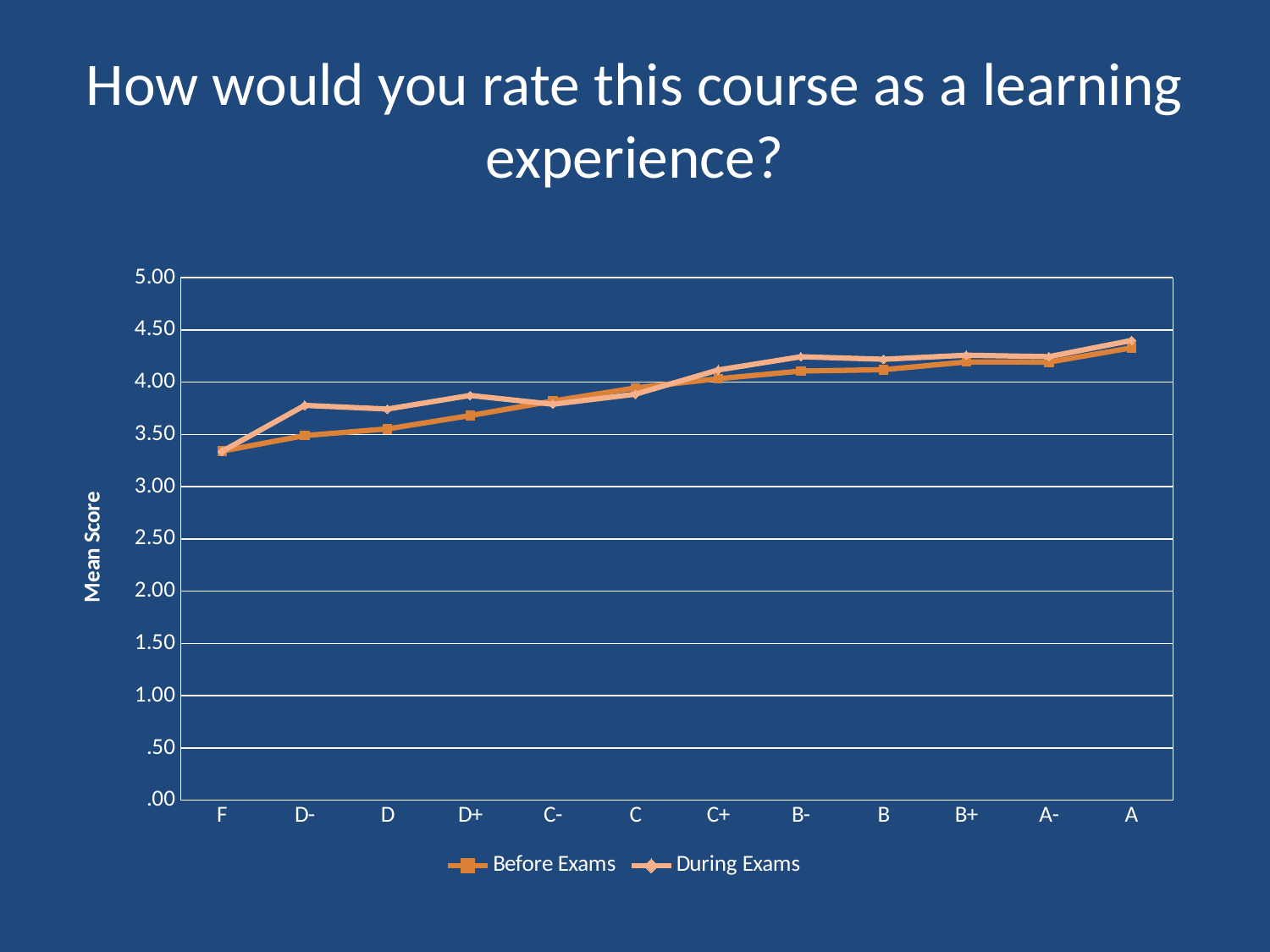
What is the label on the vertical axis? Mean Score Is the During Exams value for D- greater or less than 3.50? greater Do the Before Exams values generally rise or fall from F to A along the x axis? rise What kind of chart is shown on the slide? line chart Is the During Exams value for B- greater or less than 4.00? greater Is the Before Exams value for F greater or less than 3.50? less How many series does the legend list? 2 How many grade categories are shown along the x axis? 12 For which grade is the During Exams mean score lowest? F At grade D-, which series has the higher mean score, Before Exams or During Exams? During Exams For which grade is the Before Exams mean score highest? A